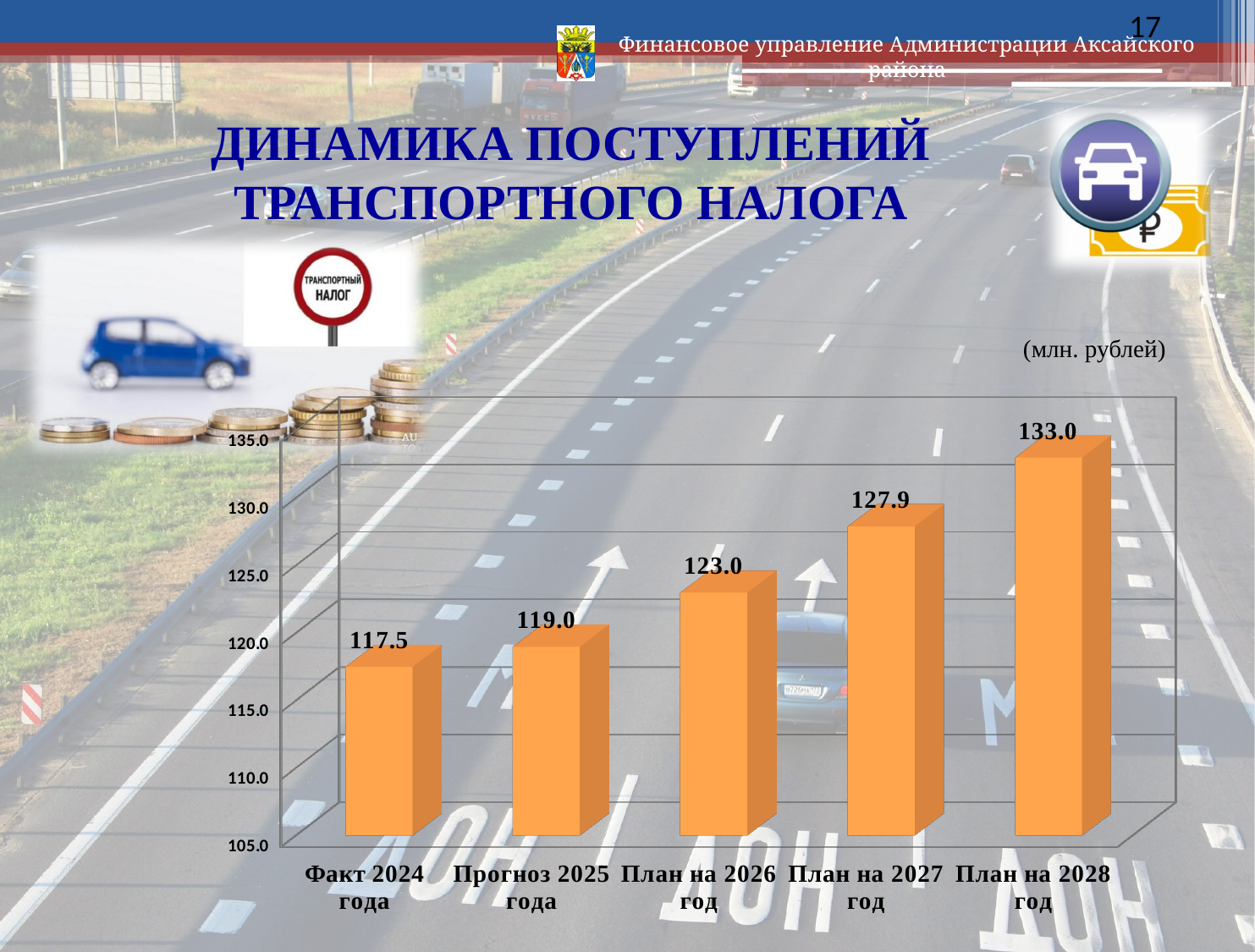
Which is larger, the value for План на 2027 год or the value for Прогноз 2025 года? План на 2027 год What is the value for План на 2028 год? 133.0 What is the value for Прогноз 2025 года? 119.0 What is the value for План на 2026 год? 123.0 What kind of chart is shown on the slide? bar chart What is the difference between the values for План на 2027 год and План на 2026 год? 4.9 What is the difference between the values for План на 2028 год and Факт 2024 года? 15.5 Do the values rise or fall from Факт 2024 года to План на 2028 год? rise What is the value for Факт 2024 года? 117.5 How many categories are shown on the x axis? 5 Which category has the highest value? План на 2028 год Which category has the lowest value? Факт 2024 года